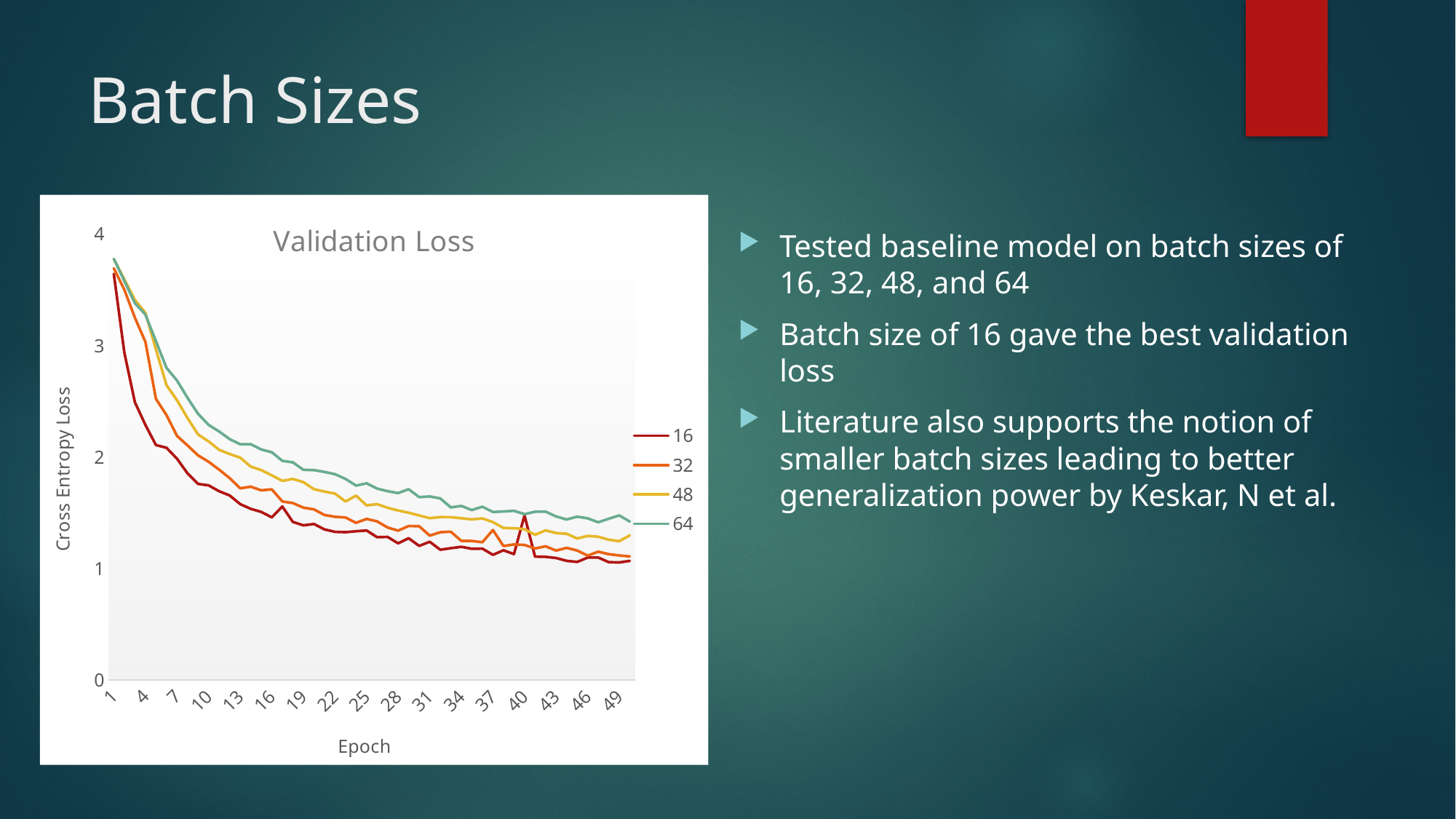
What kind of chart is shown on the slide? line chart At epoch 49, is the validation loss for batch size 16 greater or less than 2? less At epoch 25, which has the larger validation loss, batch size 32 or batch size 64? 64 At epoch 10, is the validation loss for batch size 64 greater or less than 2? greater Do the validation loss values rise or fall as the epoch increases? fall What is the label of the y axis of the chart? Cross Entropy Loss Which series has the lowest validation loss at epoch 49? 16 At epoch 1, is the validation loss for batch size 16 greater or less than 3? greater What is the title of the chart? Validation Loss How many series does the legend of the Validation Loss chart list? 4 Which series has the highest validation loss at epoch 49? 64